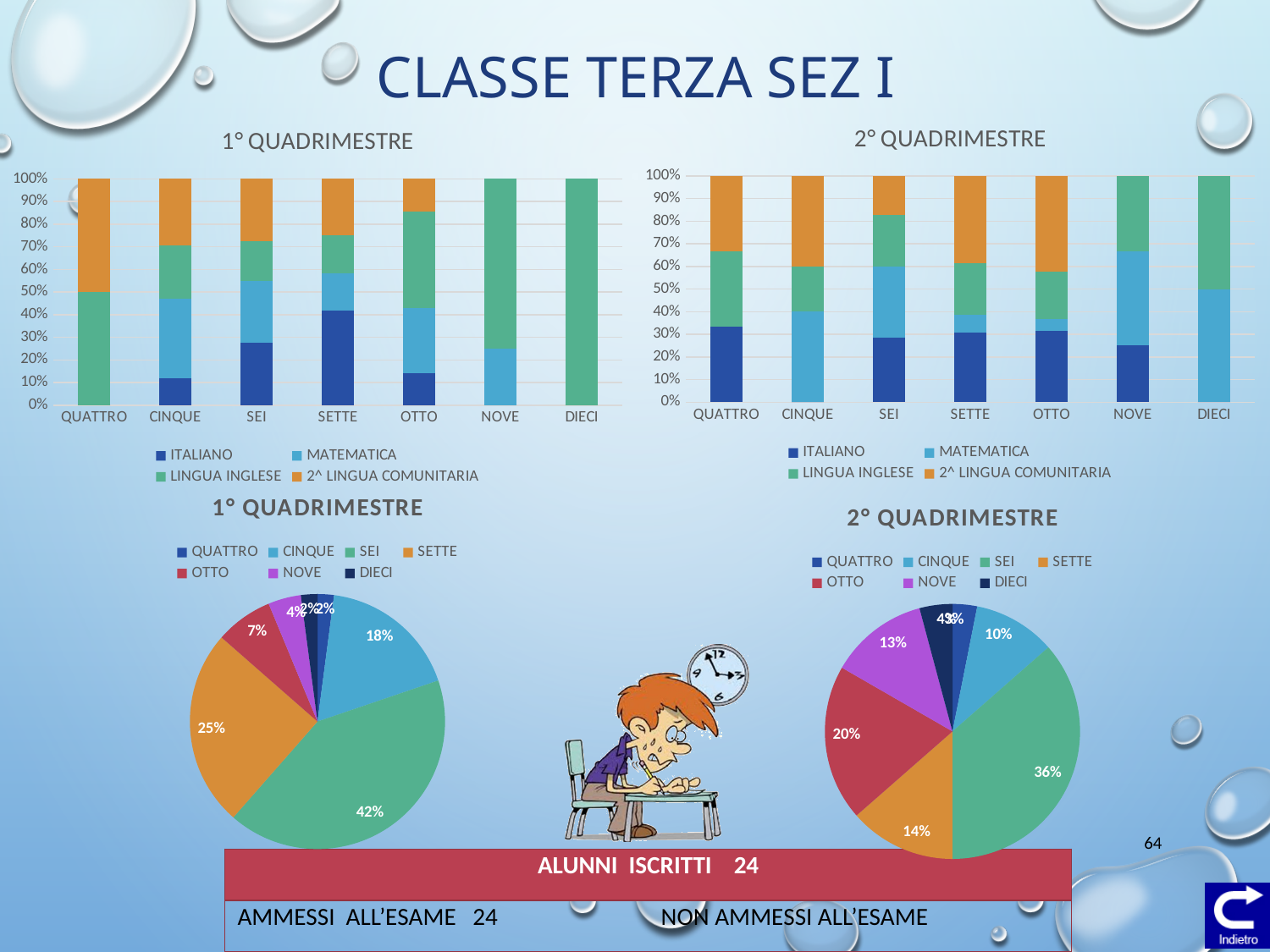
What kind of chart is the 1° Quadrimestre chart at the top left of the slide? Stacked bar chart In the 1° Quadrimestre pie chart, what share does SEI have? 42% Which series are listed in the legend of the 1° Quadrimestre bar chart at the top left? ITALIANO, MATEMATICA, LINGUA INGLESE, 2^ LINGUA COMUNITARIA In the 2° Quadrimestre pie chart, which is larger, OTTO or SETTE? OTTO How many series does the legend of the 2° Quadrimestre bar chart at the top right list? 4 How many categories are shown on the x axis of the 1° Quadrimestre bar chart at the top left? 7 In the 1° Quadrimestre pie chart, what share does SETTE have? 25% In the 2° Quadrimestre pie chart, what share does OTTO have? 20% In the 1° Quadrimestre pie chart, what is the difference between the shares of SEI and SETTE? 17 percentage points In the 2° Quadrimestre bar chart at the top right, is the ITALIANO value for QUATTRO greater or less than 30%? greater In the 1° Quadrimestre pie chart, which category has the largest slice? SEI